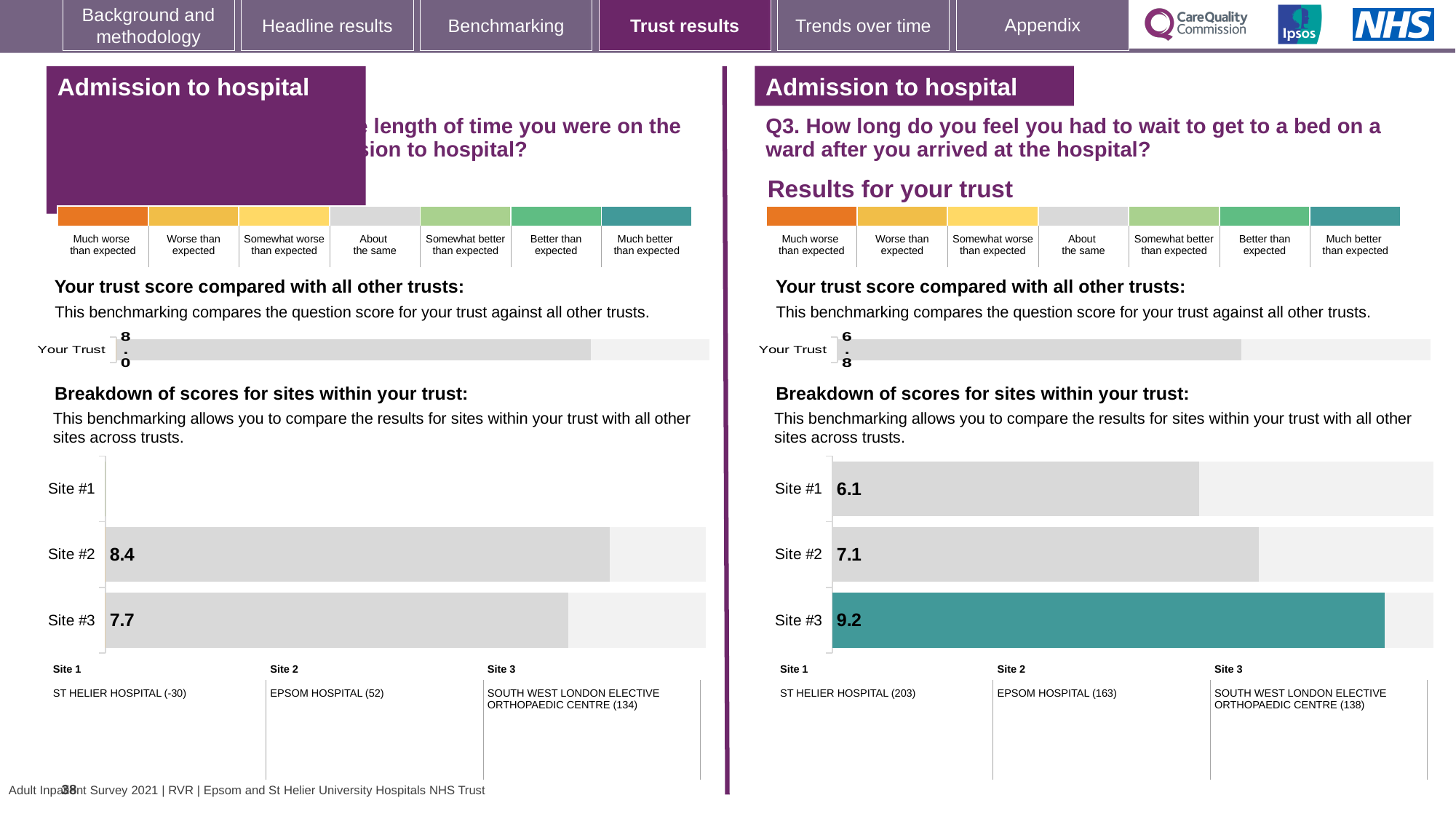
On the right-hand chart (Q3), what is the 'Your Trust' score shown in the trust comparison bar? 6.8 On the left-hand chart (breakdown of scores for sites), what is the score for Site #2? 8.4 On the right-hand chart (Q3, wait to get to a bed on a ward), what is the score for Site #3? 9.2 On the right-hand chart (Q3), what is the score for Site #1? 6.1 On the right-hand chart (Q3), what is the difference between the scores for Site #3 and Site #1? 3.1 On the right-hand chart (Q3), what is the score for Site #2? 7.1 On the left-hand chart, what is the 'Your Trust' score shown in the trust comparison bar? 8.0 On the left-hand chart, which of Site #2 or Site #3 has the higher score? Site #2 What type of chart is used for the breakdown of scores for sites on the right-hand side? Bar chart On the right-hand chart (Q3), which site has the lowest score? Site #1 On the right-hand chart (Q3), which site has the highest score? Site #3 On the left-hand chart (breakdown of scores for sites), what is the score for Site #3? 7.7